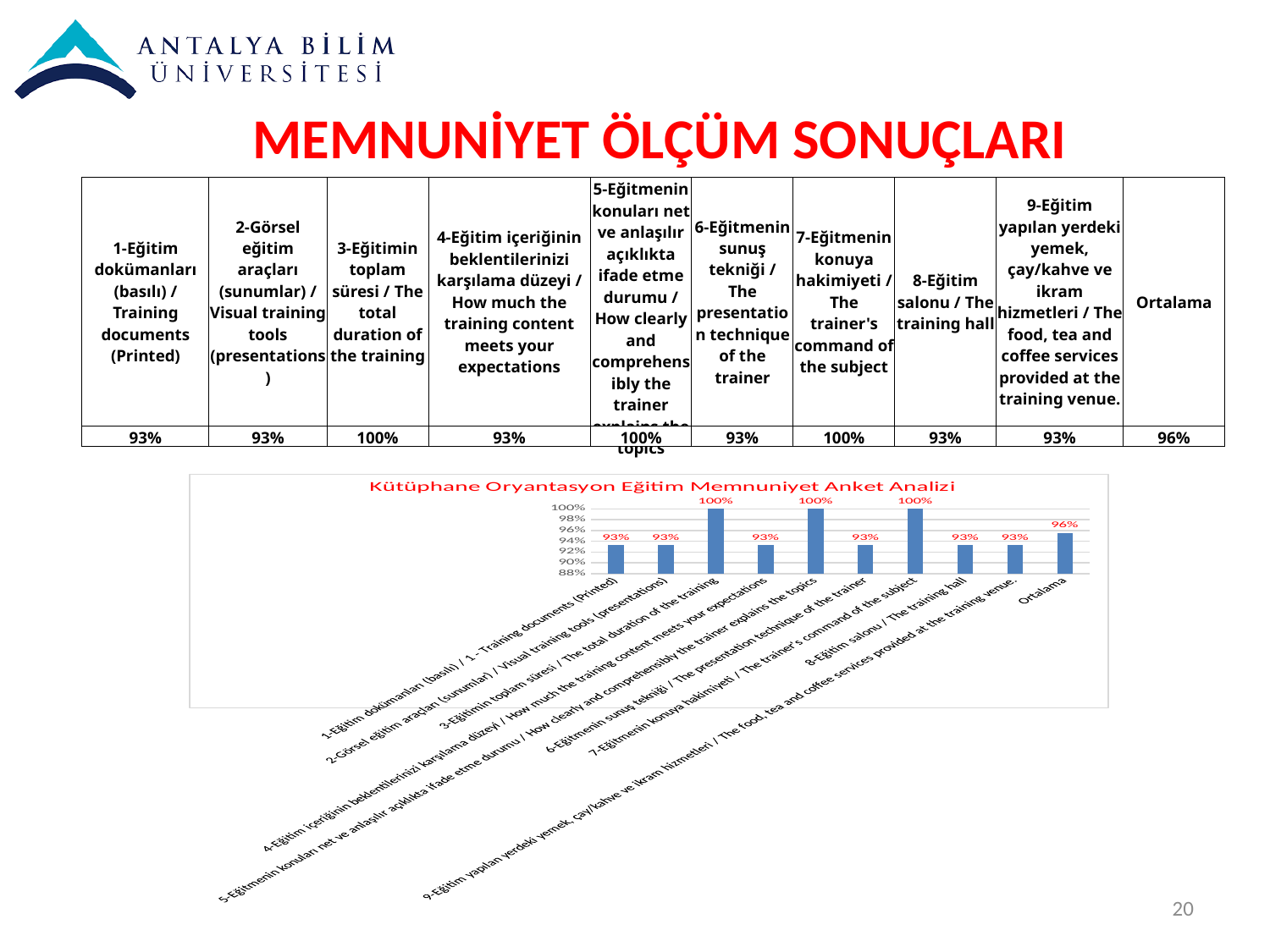
What is the value for 'Ortalama' in the chart? 96% What is the title of the chart? Kütüphane Oryantasyon Eğitim Memnuniyet Anket Analizi Which is larger: the value for '3-Eğitimin toplam süresi / The total duration of the training' or the value for '2-Görsel eğitim araçları (sunumlar) / Visual training tools (presentations)'? 3-Eğitimin toplam süresi / The total duration of the training What is the difference between the value for '7-Eğitmenin konuya hakimiyeti / The trainer's command of the subject' and the value for 'Ortalama'? 4% How many bars in the chart have a value of 100%? 3 What is the highest value shown in the chart? 100% What is the value for '8-Eğitim salonu / The training hall'? 93% What kind of chart is shown on the slide? bar chart How many bars are plotted in the chart? 10 What is the lowest value shown in the chart? 93% What is the value for '3-Eğitimin toplam süresi / The total duration of the training'? 100% What is the value for '1-Eğitim dokümanları (basılı) / 1.- Training documents (Printed)'? 93%